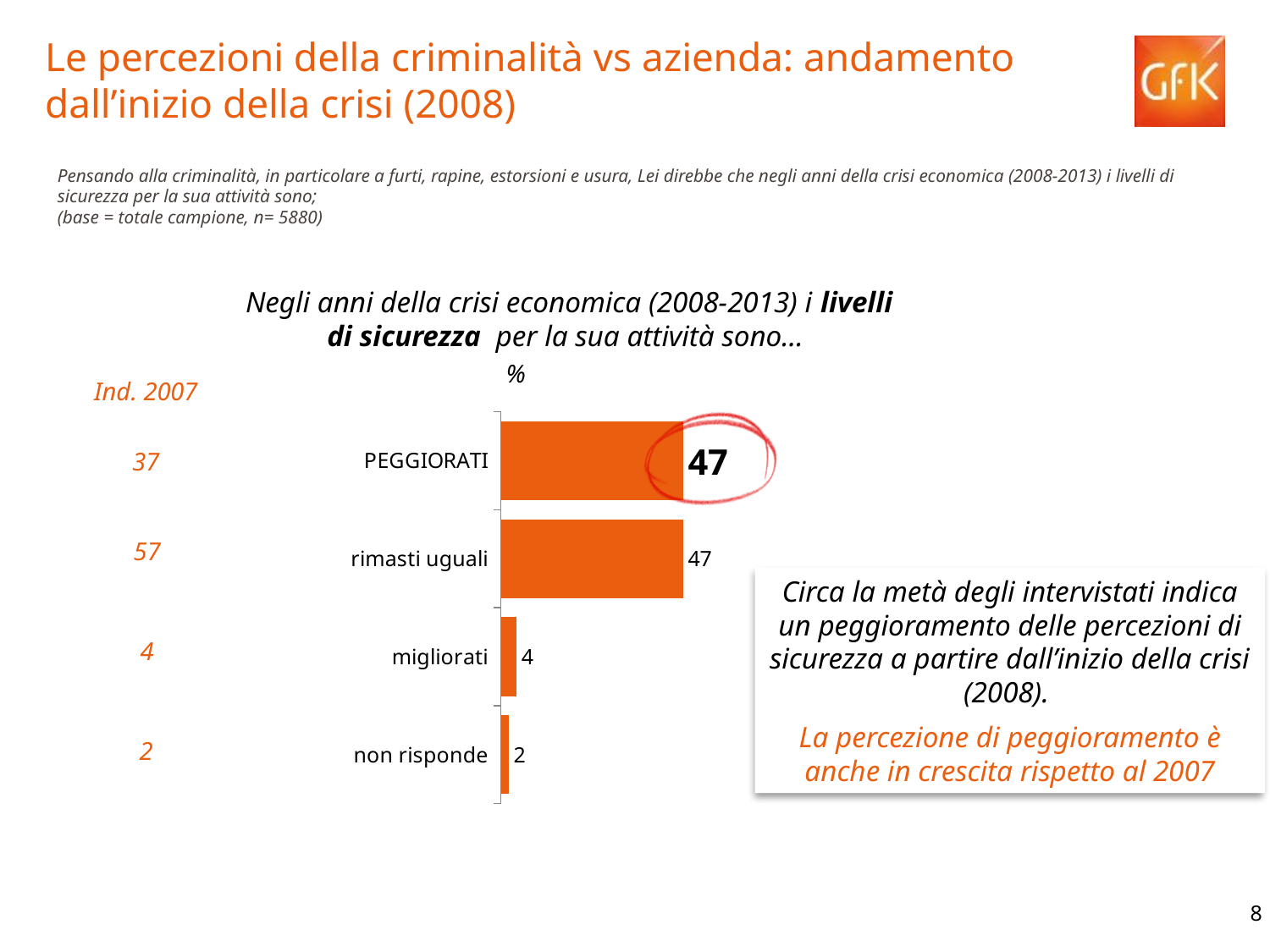
How many categories are shown in the chart? 4 What is the difference between the values for PEGGIORATI and migliorati? 43 What is the value for rimasti uguali? 47 Which is larger, the value for migliorati or the value for non risponde? migliorati What kind of chart is shown on the slide? bar chart What is the value for non risponde? 2 Which category has the lowest value? non risponde What is the value for PEGGIORATI? 47 What is the sum of the values of all four bars? 100 What is the difference between the values for migliorati and non risponde? 2 What colour are the bars in the chart? orange What is the value for migliorati? 4